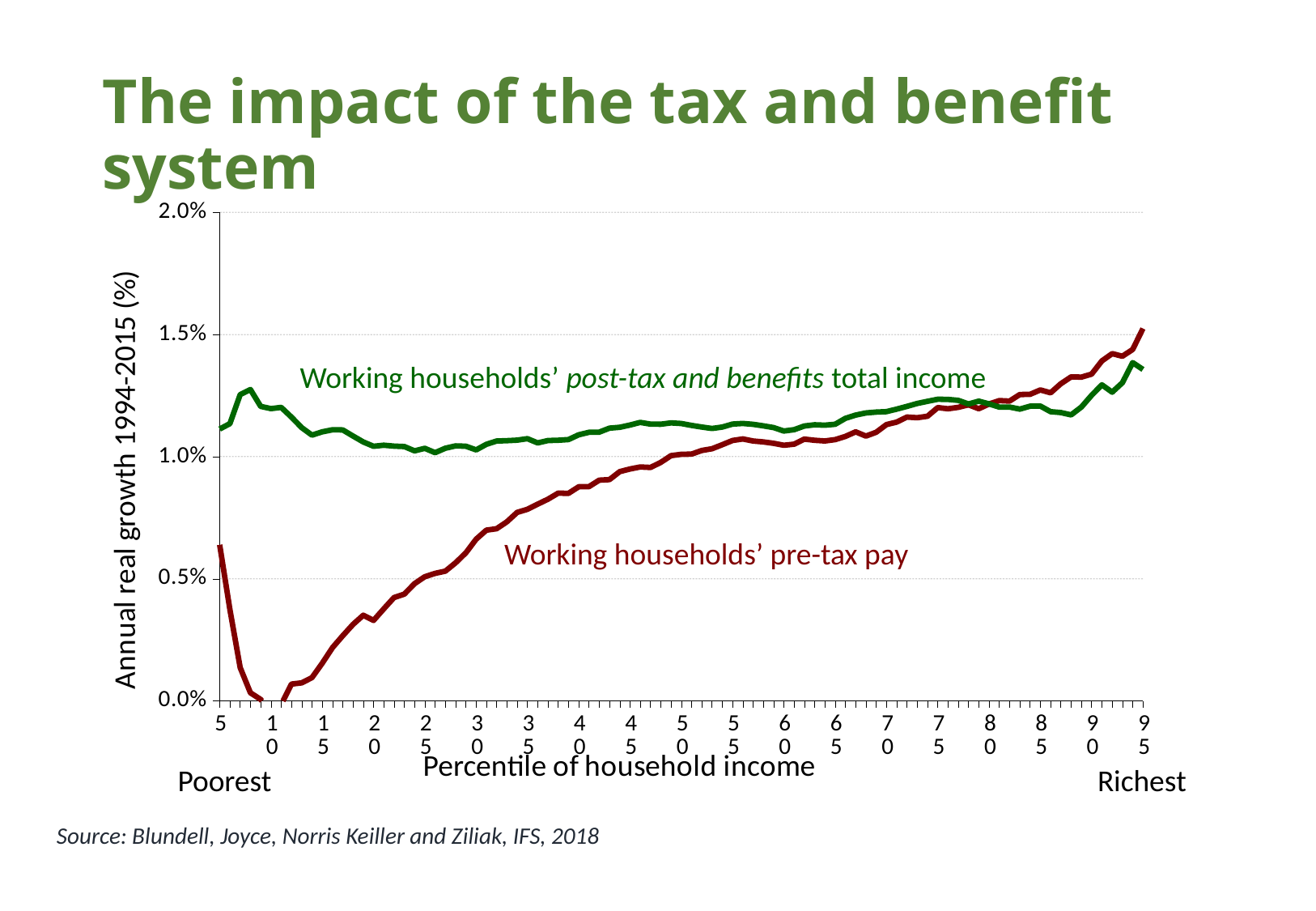
Is the value for working households' pre-tax pay at the 95th percentile greater or less than 1.0%? greater From the 10th percentile to the 95th percentile, does the working households' pre-tax pay line generally rise or fall? rise Is the value for working households' post-tax and benefits total income at the 95th percentile greater or less than 1.5%? less Is the value for working households' pre-tax pay at the 40th percentile greater or less than 1.0%? less What kind of chart is shown on the slide? line chart At the 95th percentile, which series has the higher value: pre-tax pay or post-tax and benefits total income? pre-tax pay How many data series are plotted on the chart? 2 What is the label of the horizontal axis? Percentile of household income At the 20th percentile, which series has the higher value: pre-tax pay or post-tax and benefits total income? post-tax and benefits total income What is the label of the vertical axis? Annual real growth 1994-2015 (%) How many percentile values are labelled on the horizontal axis? 19